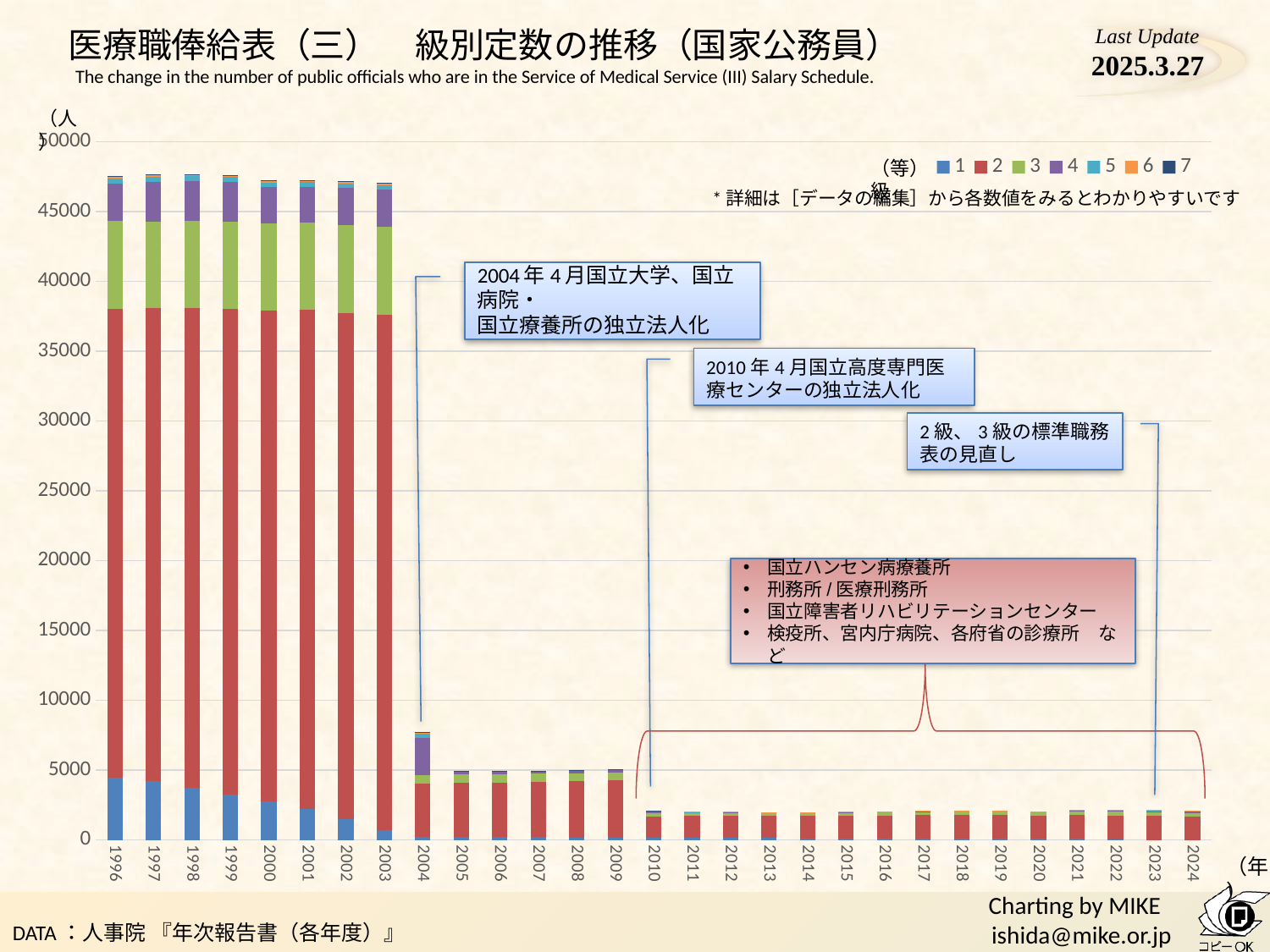
What is the first year shown on the x axis? 1996 What kind of chart is shown on the slide? stacked bar chart How many series does the legend list? 7 Is the total value for 2024 greater or less than 5000? less Is the total value for 1996 greater or less than 45000? greater Which year has the larger total bar, 2004 or 2010? 2004 Is the total value for 2004 greater or less than 5000? greater Do the total values rise or fall along the x axis from 1996 to 2024? fall Which year has the larger total bar, 2003 or 2004? 2003 How many years are shown along the x axis? 29